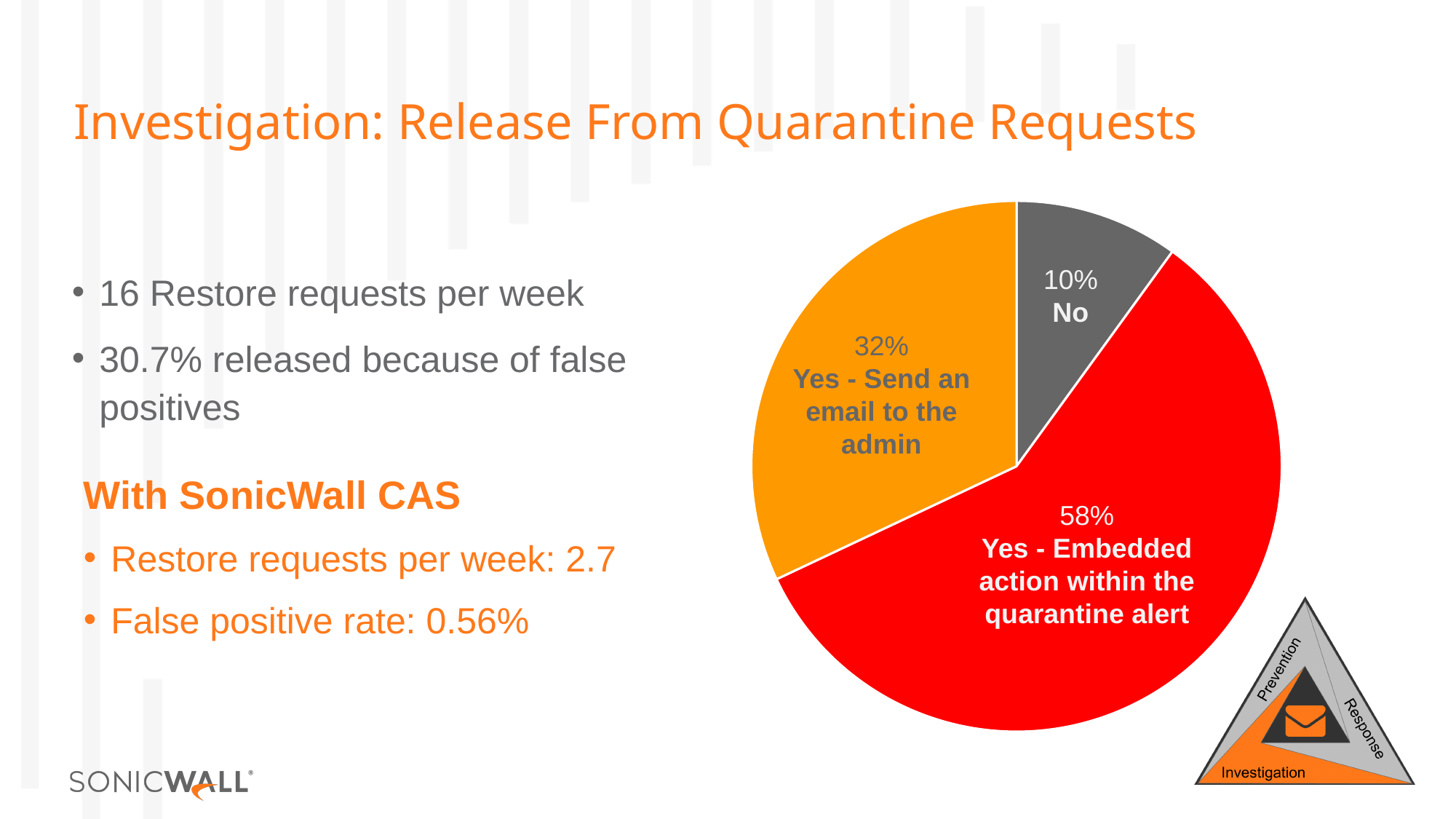
What kind of chart is shown on the slide? pie chart What share of the pie is labelled "Yes - Embedded action within the quarantine alert"? 58% What share of the pie is labelled "Yes - Send an email to the admin"? 32% What colour is the "Yes - Embedded action within the quarantine alert" slice of the pie? red What colour is the "No" slice of the pie? grey Which slice of the pie is the smallest? No How many slices does the pie chart have? 3 Which is larger: the "Yes - Send an email to the admin" slice or the "No" slice? Yes - Send an email to the admin What share of the pie is labelled "No"? 10% What is the difference in percentage points between the "Yes - Embedded action within the quarantine alert" slice and the "Yes - Send an email to the admin" slice? 26% Which slice of the pie is the largest? Yes - Embedded action within the quarantine alert What is the difference in percentage points between the "Yes - Send an email to the admin" slice and the "No" slice? 22%